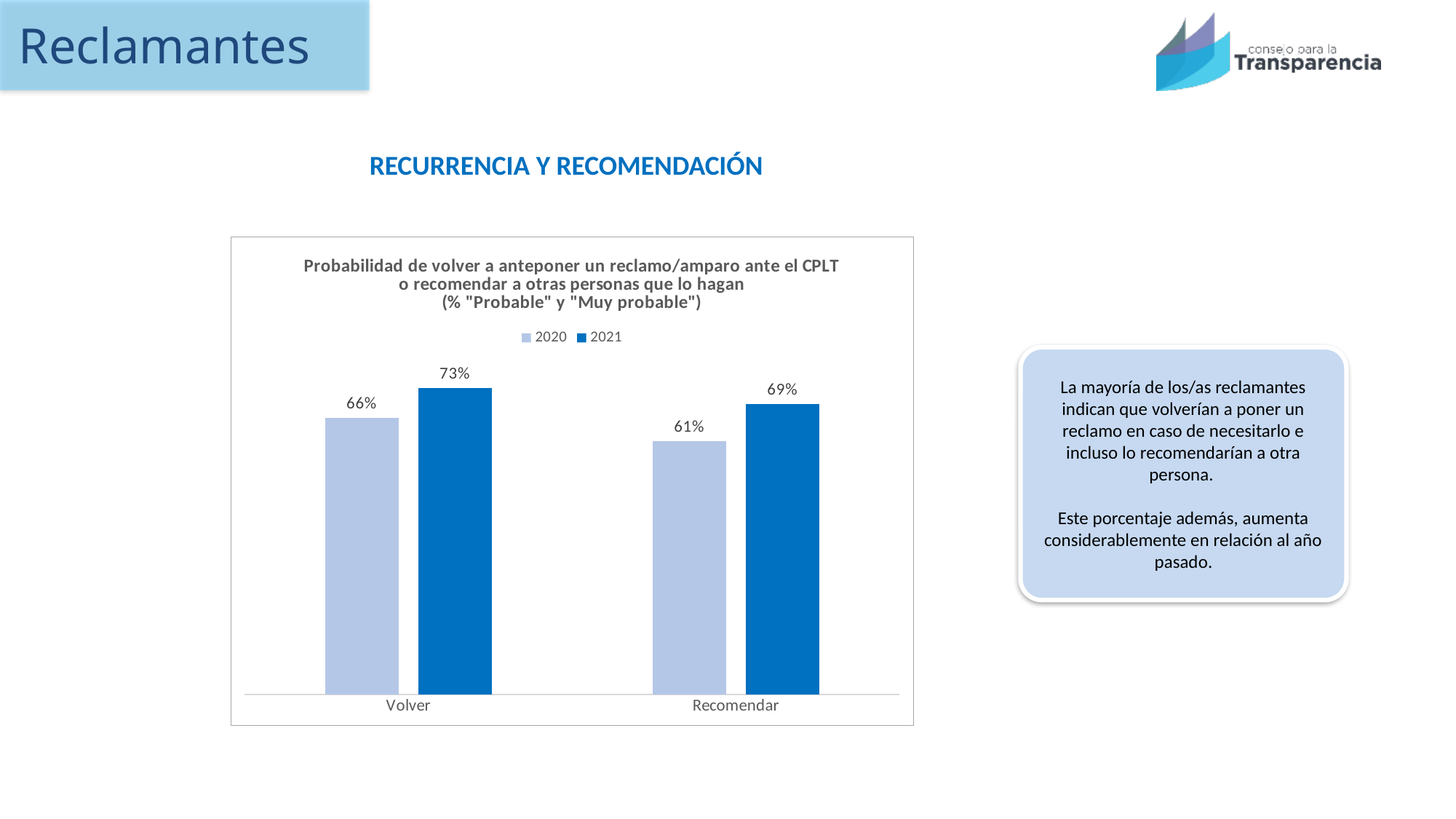
Which is larger for Recomendar: the 2020 value or the 2021 value? 2021 What is the value for Recomendar in 2020? 61% What is the value for Volver in 2021? 73% Which category has the highest value in the 2021 series? Volver How many series does the legend list? 2 What kind of chart is shown on the slide? Bar chart What is the value for Recomendar in 2021? 69% What is the difference between the 2021 and 2020 values for Volver? 7% What is the value for Volver in 2020? 66% What is the difference between the 2021 and 2020 values for Recomendar? 8% How many categories are shown on the x axis? 2 Which category has the lowest value in the 2020 series? Recomendar